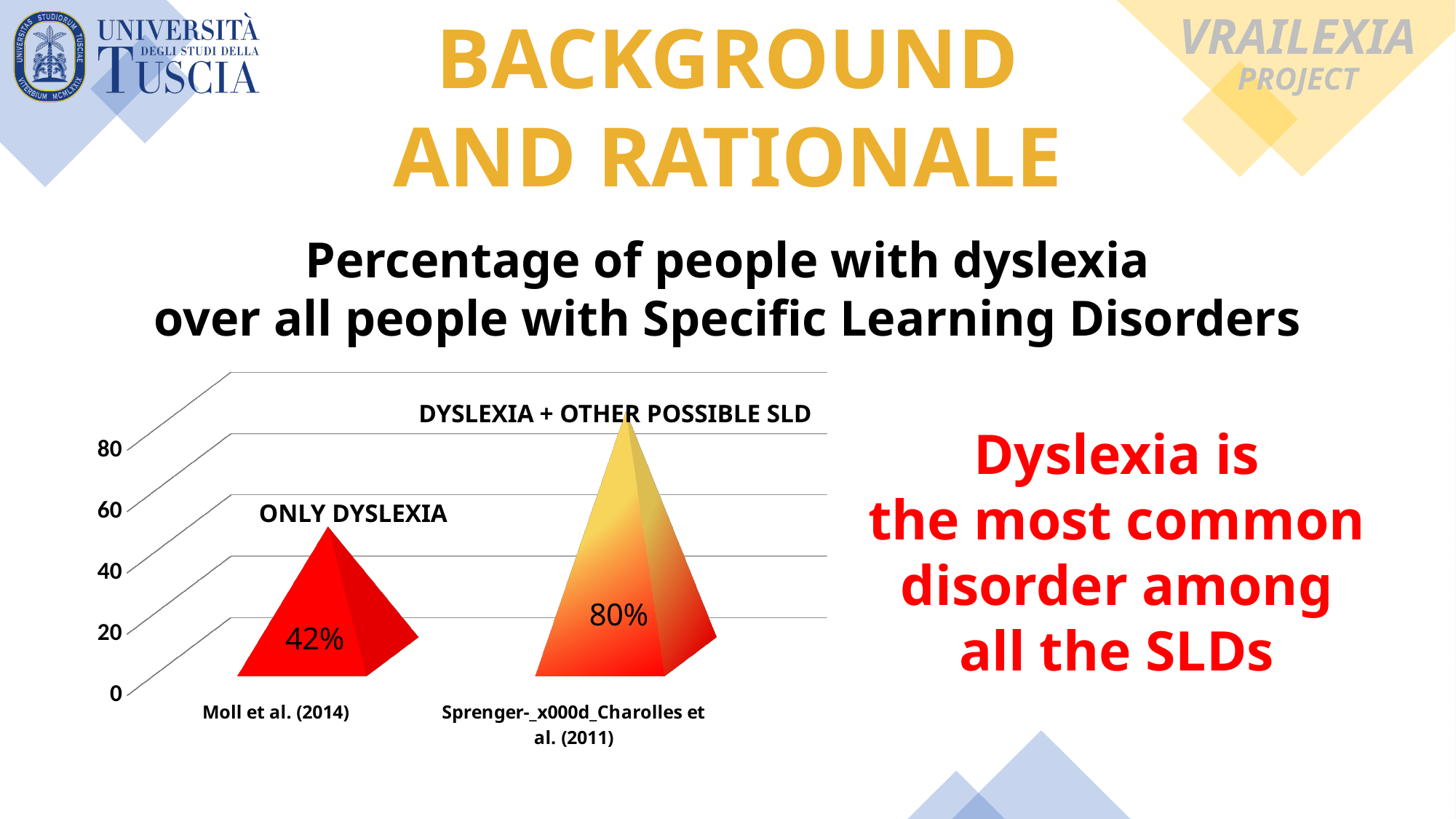
What is the value for Sprenger-Charolles et al. (2011)? 80% Which category has the highest value? Sprenger-Charolles et al. (2011) How many categories are plotted in the chart? 2 Which category has the lowest value? Moll et al. (2014) Which is larger, the value for Moll et al. (2014) or the value for Sprenger-Charolles et al. (2011)? Sprenger-Charolles et al. (2011) What is the title of the chart? Percentage of people with dyslexia over all people with Specific Learning Disorders What is the value for Moll et al. (2014)? 42% What kind of chart is shown on the slide? Bar chart What label is shown above the bar for Moll et al. (2014)? ONLY DYSLEXIA What is the difference between the value for Sprenger-Charolles et al. (2011) and the value for Moll et al. (2014)? 38% Is the value for Sprenger-Charolles et al. (2011) greater or less than 60? greater Is the value for Moll et al. (2014) greater or less than 60? less